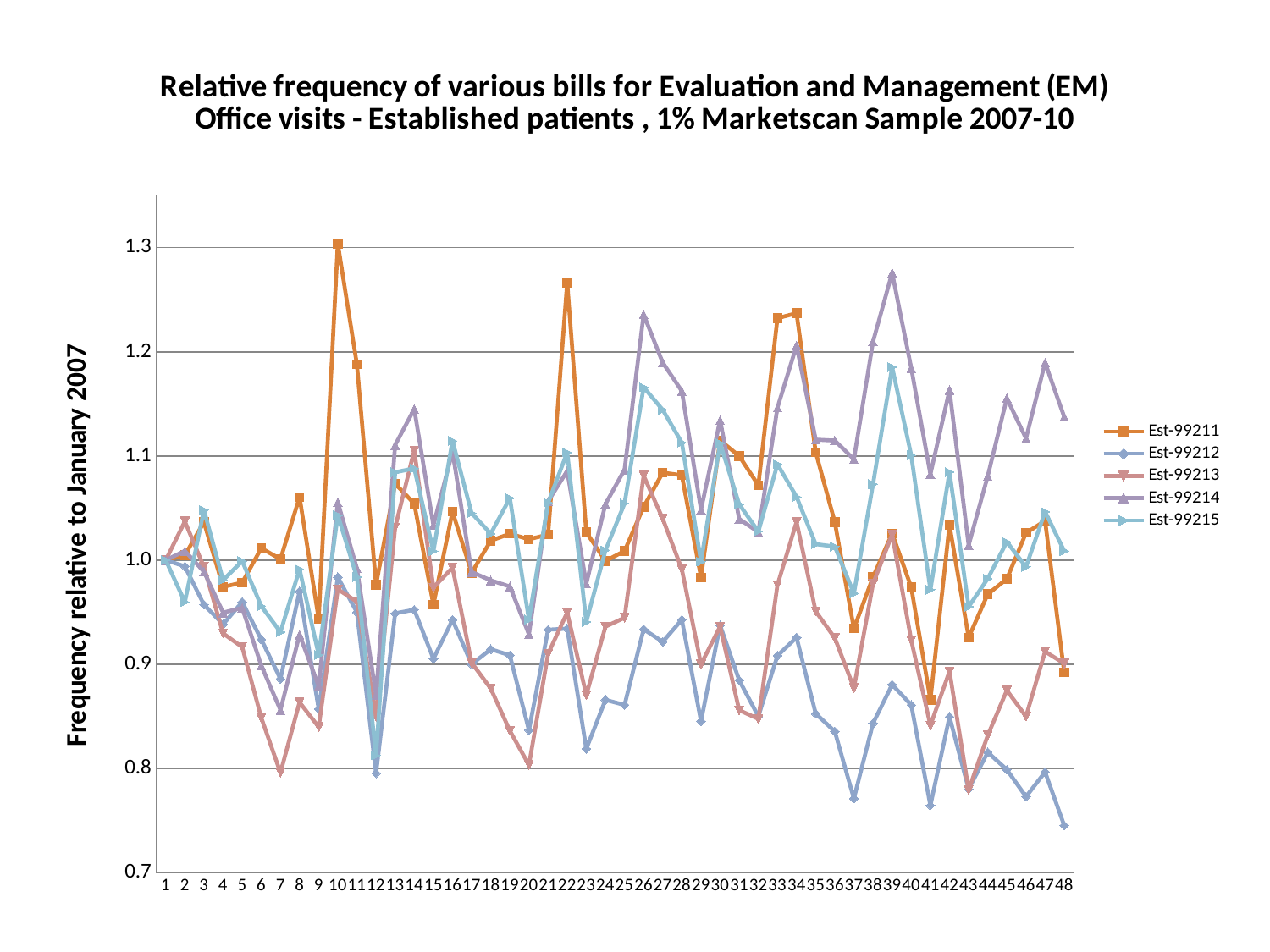
What is the label on the y axis? Frequency relative to January 2007 Is the value for Est-99213 at point 7 greater or less than 0.9? less Which series has the lowest value at point 48 on the x axis? Est-99212 Which series has the highest value at point 10 on the x axis? Est-99211 How many series does the legend list? 5 Is the value for Est-99212 at point 48 greater or less than 0.8? less Is the value for Est-99214 at point 39 greater or less than 1.2? greater What kind of chart is shown on the slide? line chart At point 48, which is larger: Est-99214 or Est-99212? Est-99214 What is the value of Est-99211 at point 1 on the x axis? 1.0 How many points are plotted along the x axis for each series? 48